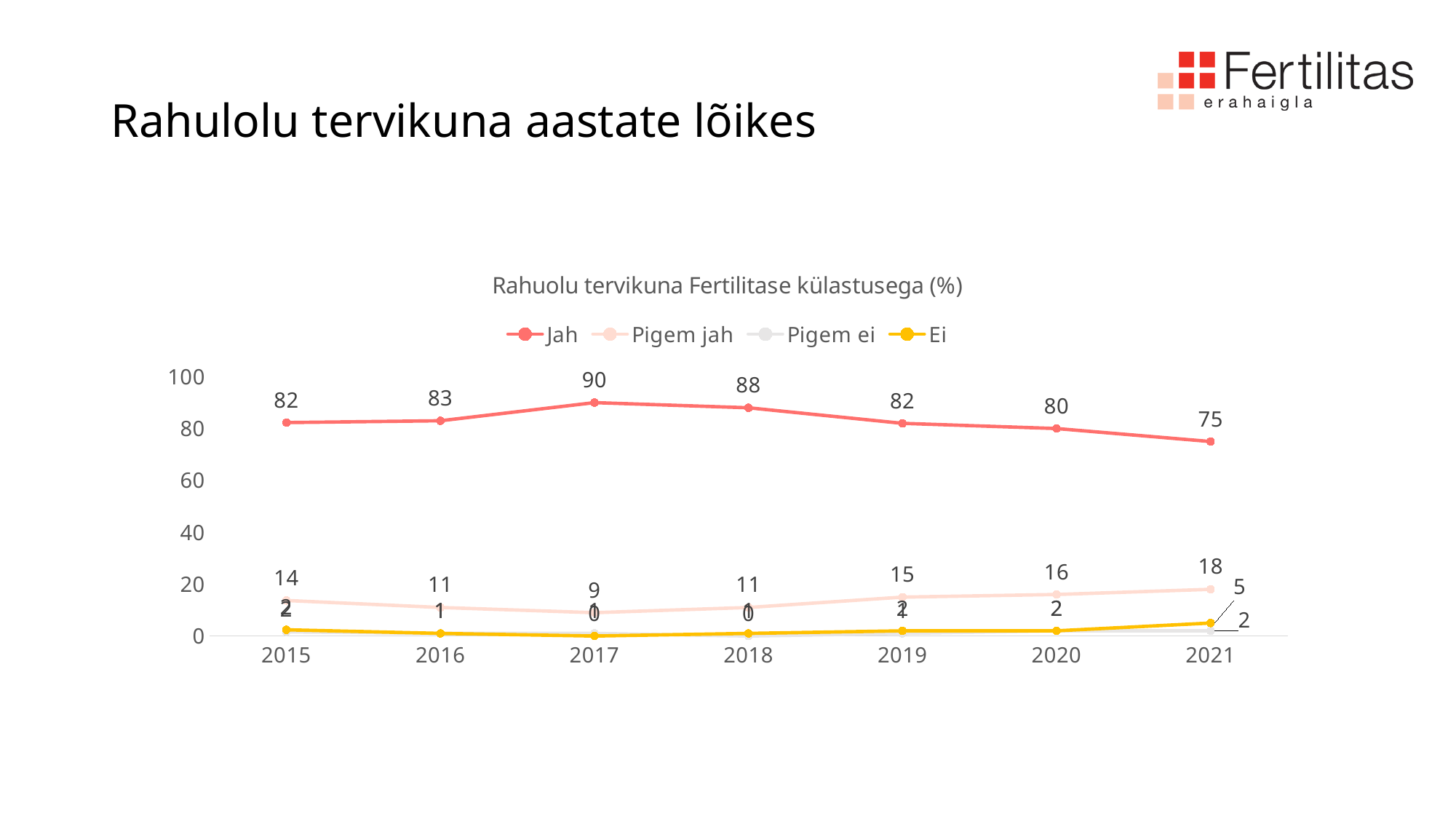
How many series does the legend list? 4 What is the value for Jah in 2021? 75 What is the value for Pigem jah in 2021? 18 Does the Jah series rise or fall from 2018 to 2021? fall Which is larger, the Pigem jah value for 2019 or for 2016? 2019 In which year is the Jah series highest? 2017 What is the value for Jah in 2017? 90 What is the difference between the Jah values for 2017 and 2021? 15 What kind of chart is shown on the slide? line chart In which year is the Pigem jah series lowest? 2017 What is the value for Pigem jah in 2015? 14 How many years are shown on the x axis? 7